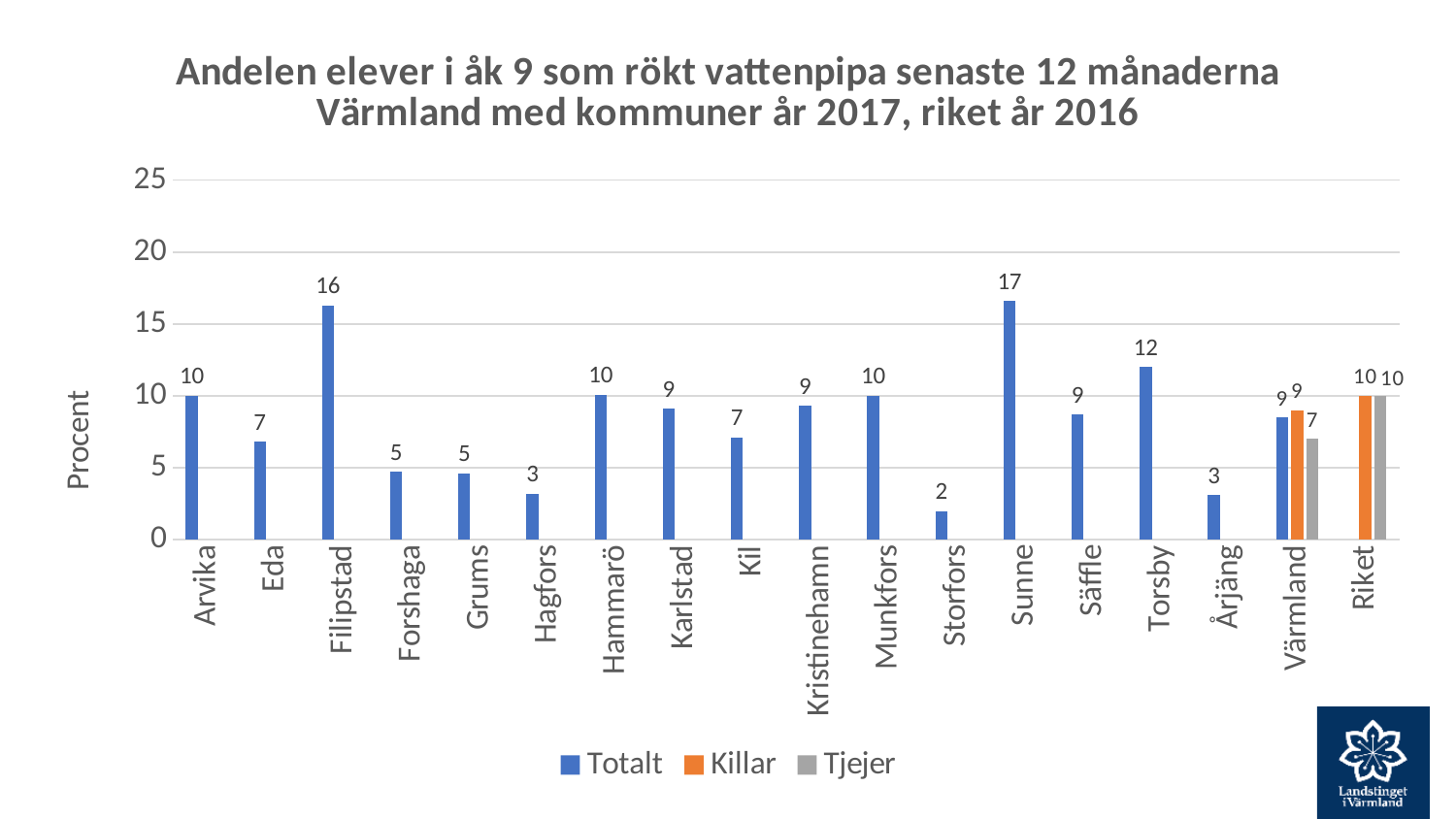
Which has a higher Totalt value, Filipstad or Torsby? Filipstad Which municipality has the lowest Totalt value? Storfors What is the difference between the Totalt values for Sunne and Torsby? 5 What is the Tjejer value for Värmland? 7 How many categories are shown on the x axis? 18 Which municipality has the highest Totalt value? Sunne What is the label of the y axis? Procent What is the Killar value for Riket? 10 What kind of chart is shown on the slide? Bar chart How many series does the legend list? 3 What is the Totalt value for Filipstad? 16 Is the Totalt value for Sunne greater or less than 15? greater